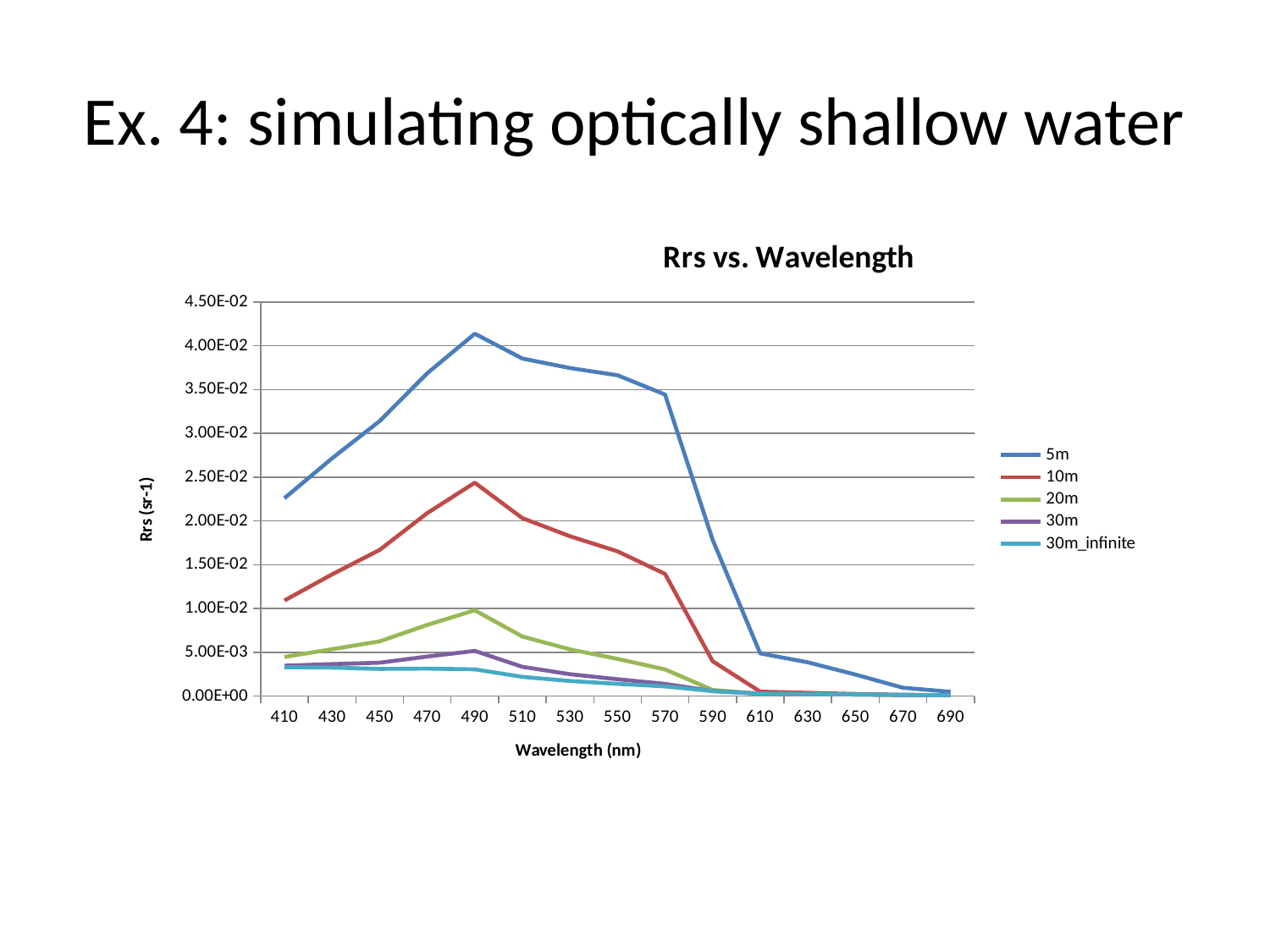
How many wavelength points are marked along the x axis? 15 Which series has the lowest Rrs value at 490 nm? 30m_infinite Does the 5m series rise or fall between 490 nm and 690 nm? fall What kind of chart is shown on the slide? line chart Which is larger at 570 nm, the 5m series or the 10m series? 5m At which wavelength does the 5m series reach its peak? 490 What is the title of the chart? Rrs vs. Wavelength What is the label of the x axis? Wavelength (nm) How many series does the legend list? 5 Is the value for the 5m series at 490 nm greater or less than 4.00E-02? greater Which series has the highest Rrs value at 490 nm? 5m Is the value for the 10m series at 490 nm greater or less than 2.00E-02? greater